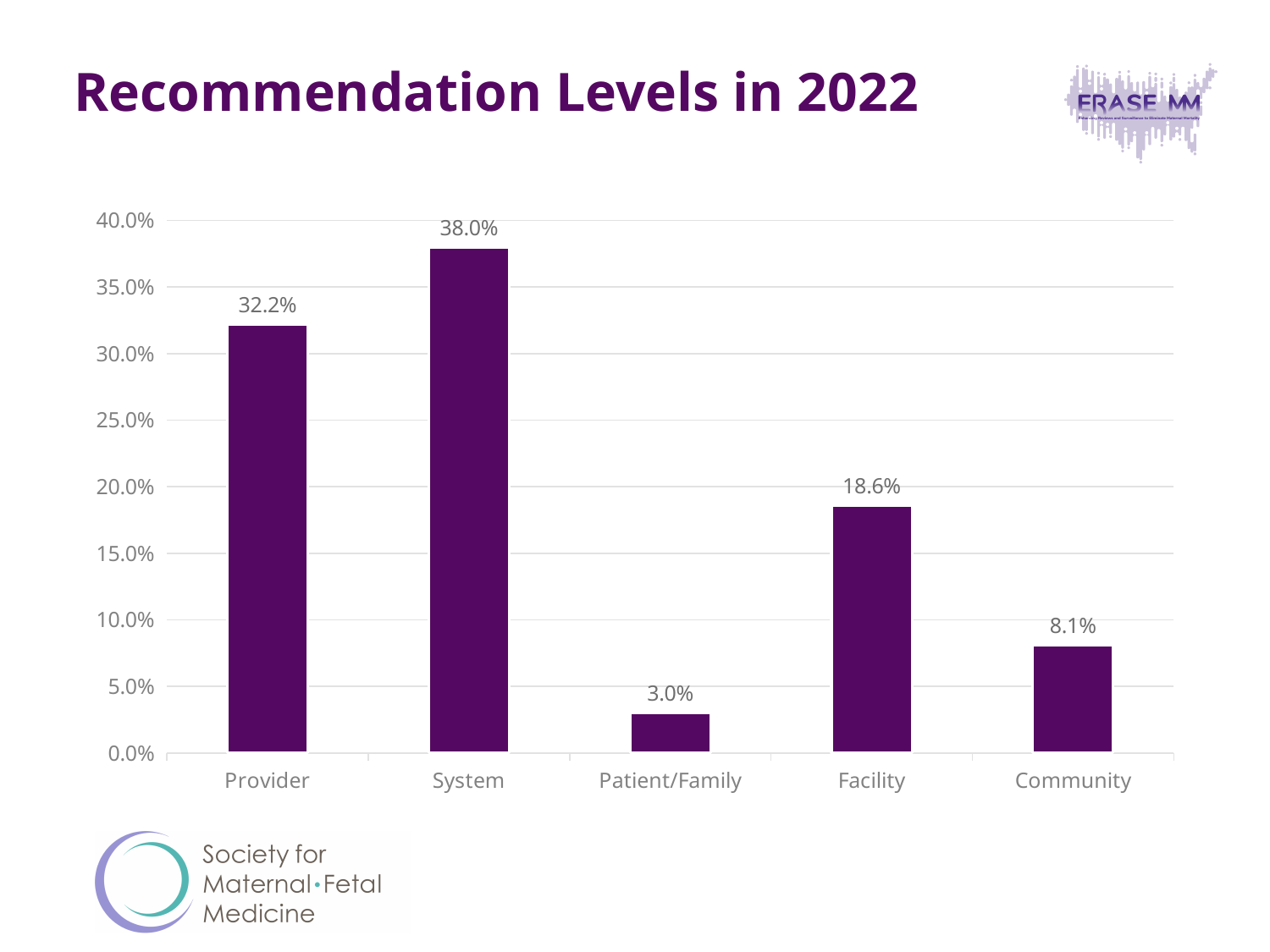
What is the value for Community? 8.1% Which is larger, the value for Facility or the value for Community? Facility How many categories are shown on the x axis? 5 What kind of chart is shown on the slide? bar chart What is the value for System? 38.0% What is the value for Provider? 32.2% What is the value for Patient/Family? 3.0% What is the difference between the values for System and Provider? 5.8% Is the value for Facility greater or less than 20.0%? less What is the value for Facility? 18.6% Which category has the lowest value? Patient/Family Which category has the highest value? System